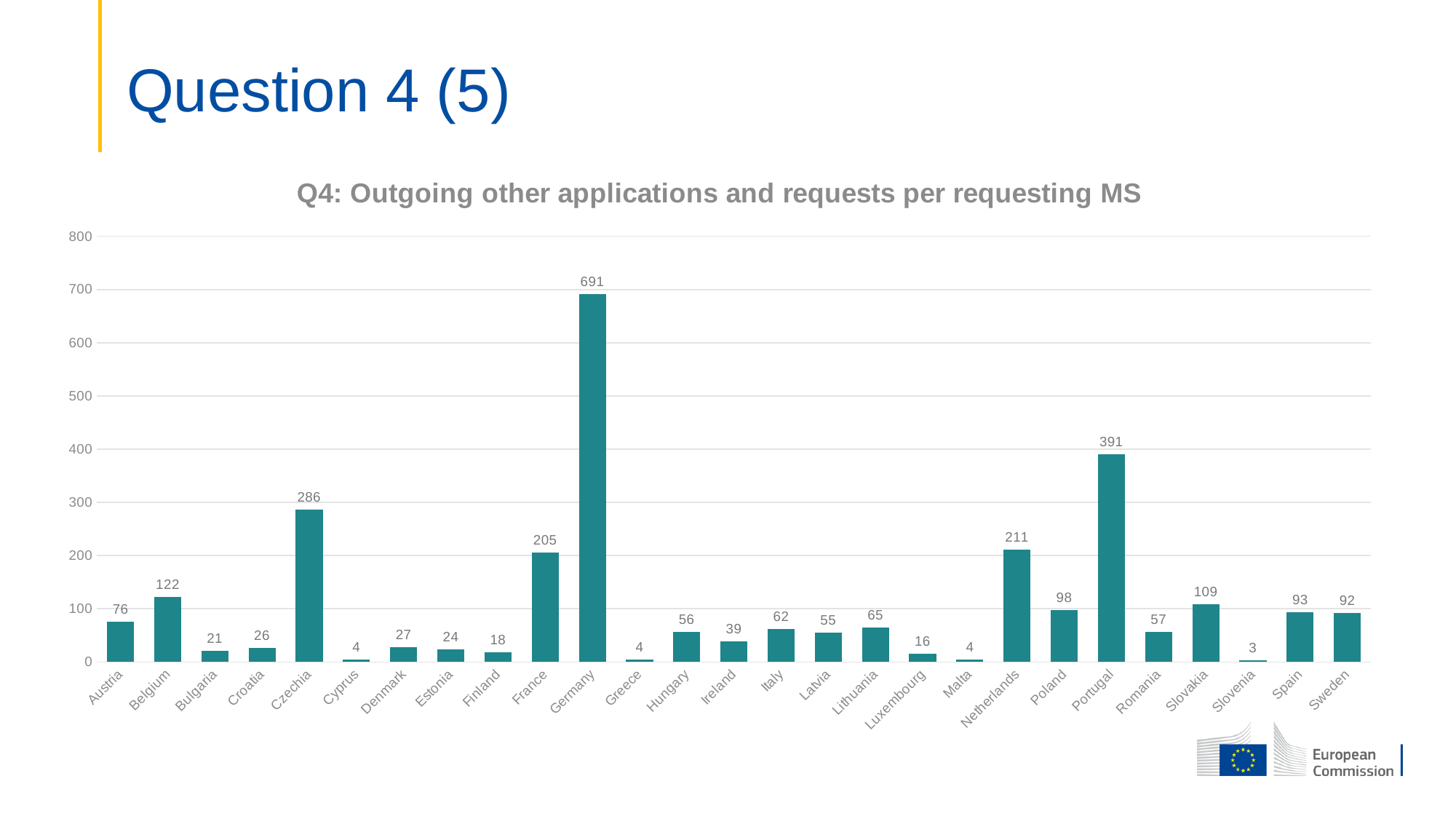
What kind of chart is this? bar chart Which country has the lowest value? Slovenia Which country has the highest value? Germany What is the difference between the values for Czechia and France? 81 What is the value for Portugal? 391 What is the difference between the values for Spain and Sweden? 1 What is the title of the chart? Q4: Outgoing other applications and requests per requesting MS What is the value for Luxembourg? 16 How many countries are shown on the x axis? 27 Is the value for Belgium greater or less than 100? greater Which has a larger value, Netherlands or France? Netherlands What is the value for Germany? 691